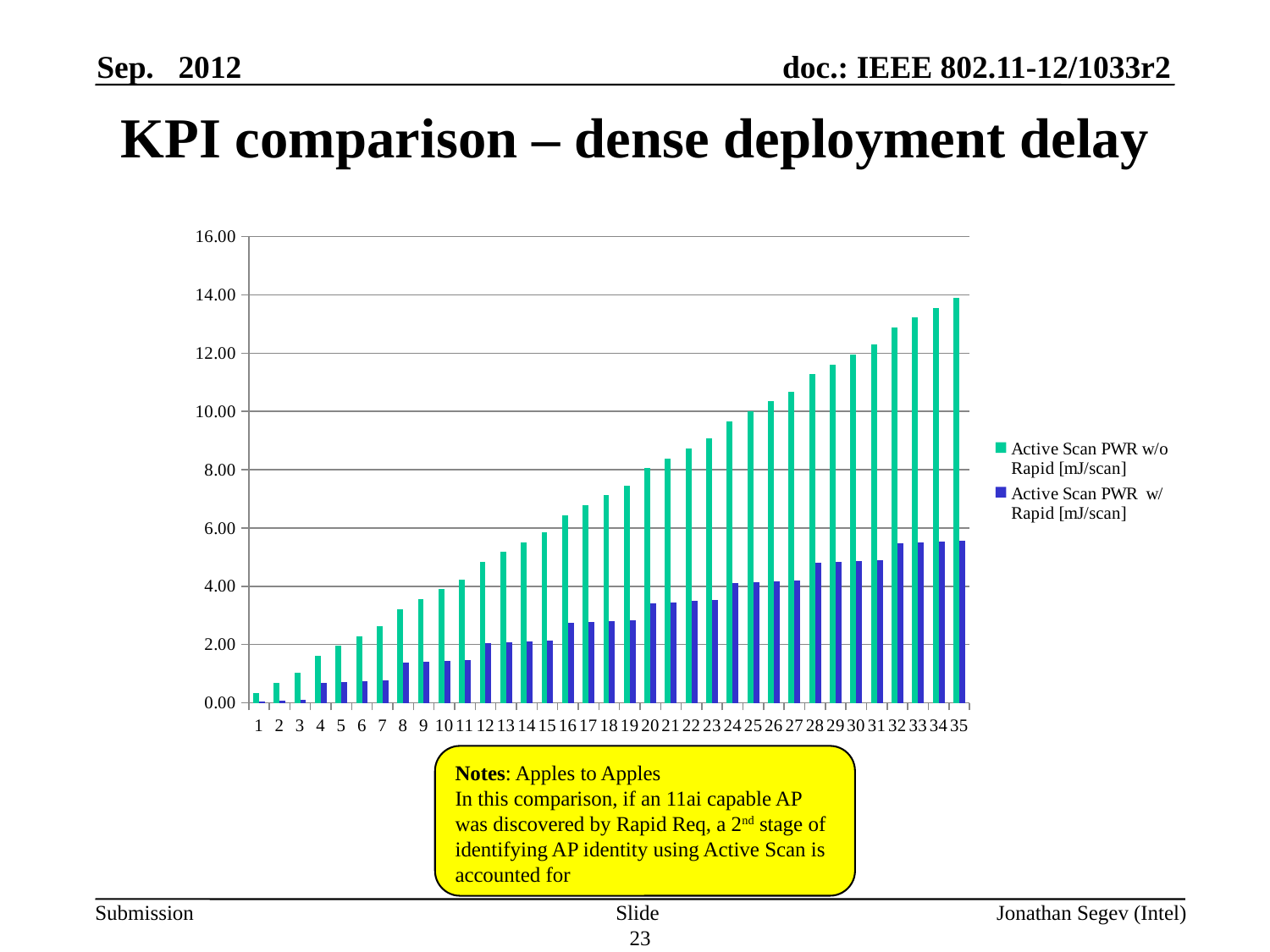
How many series does the legend list? 2 Is the value for Active Scan PWR w/ Rapid [mJ/scan] at category 10 greater or less than 2.00? less What kind of chart is shown on the slide? bar chart At category 35, which series has the larger value: Active Scan PWR w/o Rapid [mJ/scan] or Active Scan PWR w/ Rapid [mJ/scan]? Active Scan PWR w/o Rapid [mJ/scan] How many categories are shown along the x axis? 35 Do the values for Active Scan PWR w/o Rapid [mJ/scan] rise or fall as the category number increases from 1 to 35? rise At which category is the value for Active Scan PWR w/o Rapid [mJ/scan] highest? 35 Is the value for Active Scan PWR w/o Rapid [mJ/scan] at category 35 greater or less than 12.00? greater At which category is the value for Active Scan PWR w/o Rapid [mJ/scan] lowest? 1 Is the value for Active Scan PWR w/ Rapid [mJ/scan] at category 20 greater or less than 4.00? less Which series is drawn in blue in the chart? Active Scan PWR w/ Rapid [mJ/scan]